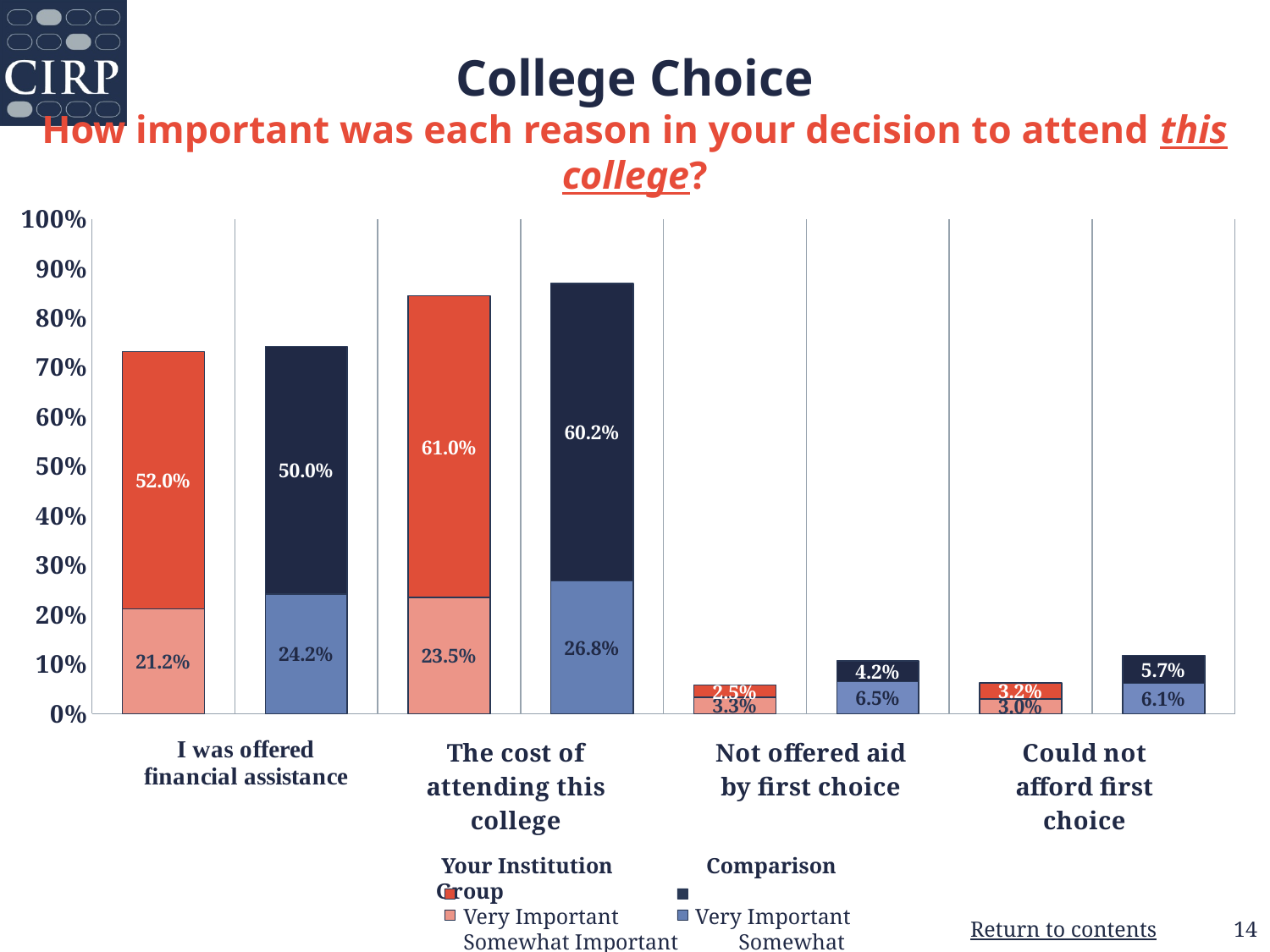
How many reasons (categories) are shown on the x axis? 4 Is the total stacked bar for the Comparison Group on 'The cost of attending this college' greater or less than 80%? greater What percentage of the Comparison Group rated 'Could not afford first choice' as Very Important? 5.7% Which reason has the lowest Very Important percentage for Your Institution? Not offered aid by first choice What type of chart is shown on the slide? Stacked bar chart What percentage of students at Your Institution rated 'Not offered aid by first choice' as Somewhat Important? 3.3% For 'Could not afford first choice', which group has the larger Somewhat Important percentage, Your Institution or the Comparison Group? Comparison Group What percentage of students at Your Institution rated 'The cost of attending this college' as Very Important? 61.0% Which reason has the highest Very Important percentage for Your Institution? The cost of attending this college What percentage of the Comparison Group rated 'I was offered financial assistance' as Somewhat Important? 24.2% What is the combined Very Important and Somewhat Important percentage for Your Institution on 'The cost of attending this college'? 84.5% What is the difference between the Very Important percentages for Your Institution and the Comparison Group on 'I was offered financial assistance'? 2.0%